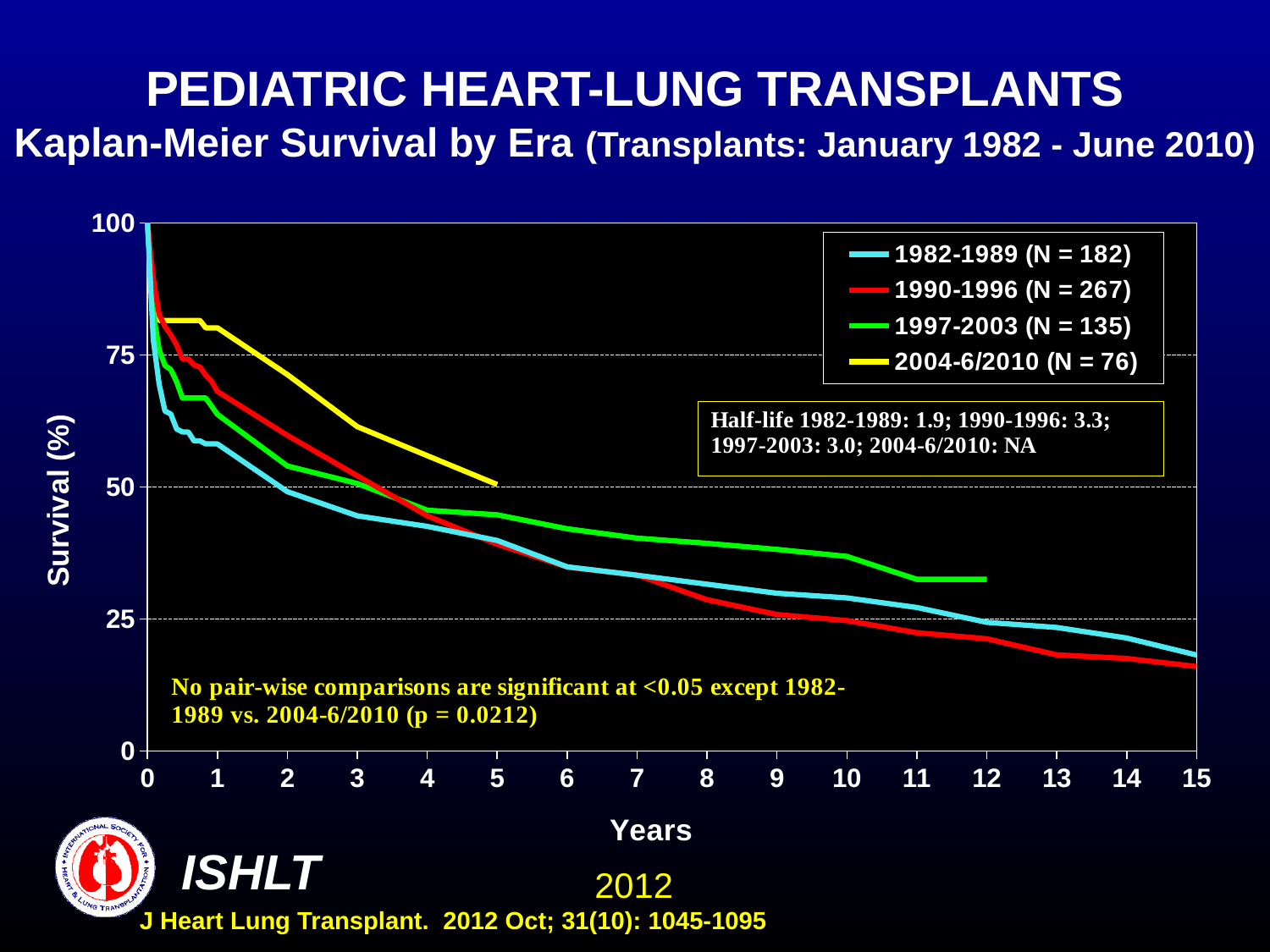
At year 10, which era has higher survival, 1997-2003 or 1990-1996? 1997-2003 Which era has the lowest survival at year 1? 1982-1989 Is the survival for 1982-1989 at year 5 greater or less than 50? less Is the survival for 2004-6/2010 at year 3 greater or less than 50? greater What is the N for the 1990-1996 era shown in the legend? 267 Do the survival curves rise or fall as years increase? fall How many series does the legend list? 4 What is the half-life reported for the 1982-1989 era? 1.9 What kind of chart is shown on the slide? line chart Is the survival for 1997-2003 at year 10 greater or less than 25? greater Which era has the highest survival at year 3? 2004-6/2010